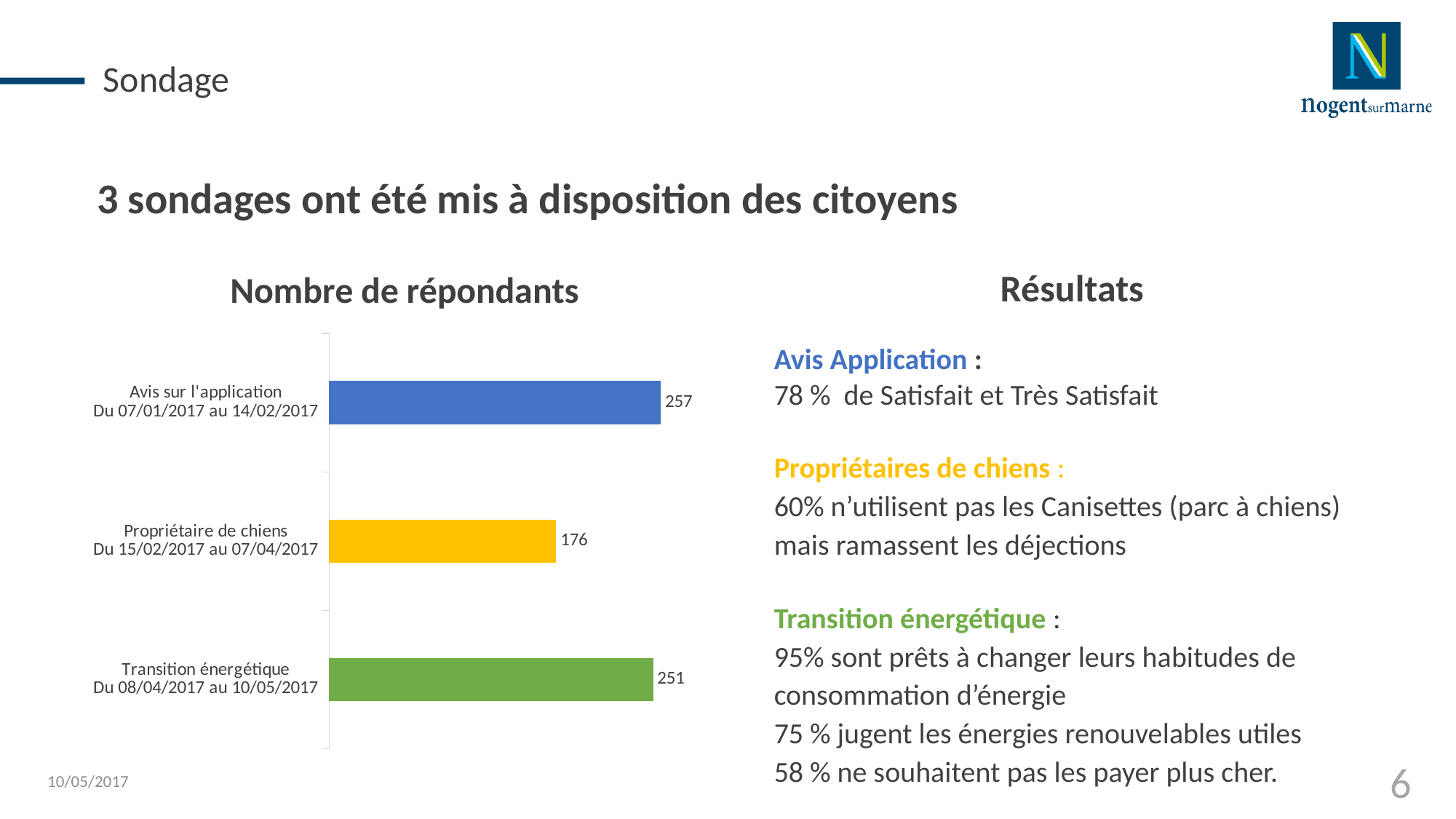
How many respondents did the 'Propriétaire de chiens' survey have? 176 What type of chart is used to show the number of respondents? Bar chart How many respondents did the 'Transition énergétique' survey have? 251 What is the difference in respondents between 'Transition énergétique' and 'Propriétaire de chiens'? 75 Which had more respondents, 'Transition énergétique' or 'Propriétaire de chiens'? Transition énergétique What is the difference in respondents between 'Avis sur l'application' and 'Propriétaire de chiens'? 81 Which survey had the lowest number of respondents? Propriétaire de chiens What colour is the bar for 'Propriétaire de chiens'? Yellow Which survey had the highest number of respondents? Avis sur l'application How many surveys are shown in the chart? 3 What is the title of the chart? Nombre de répondants How many respondents did the 'Avis sur l'application' survey have? 257